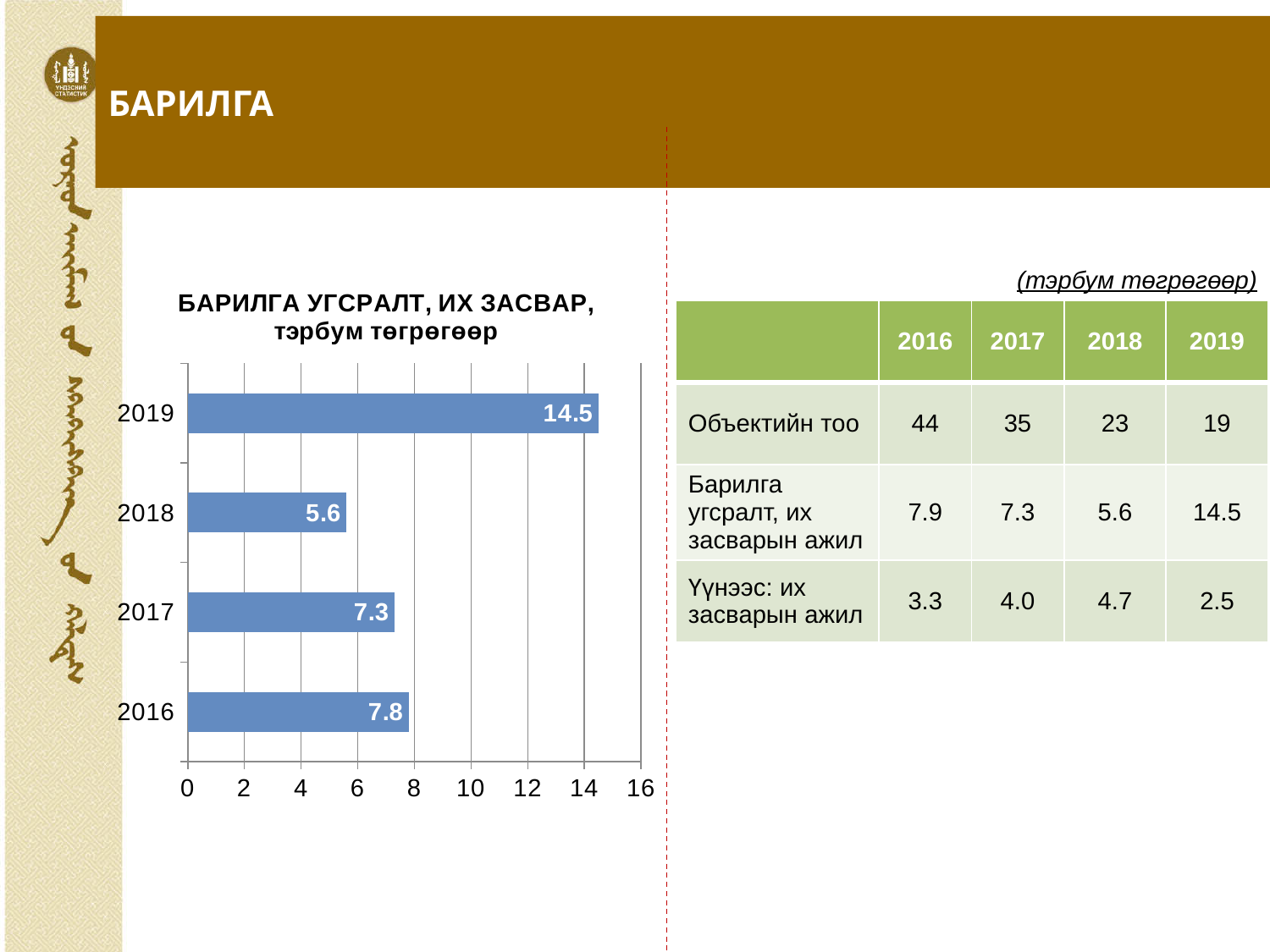
Which year has the highest value in the chart? 2019 What is the value for 2016 in the chart? 7.8 What is the difference between the values for 2016 and 2017 in the chart? 0.5 What is the value for 2018 in the chart? 5.6 Which is larger in the chart, the value for 2016 or the value for 2017? 2016 What kind of chart is shown on the slide? bar chart Which year has the lowest value in the chart? 2018 What is the difference between the values for 2019 and 2018 in the chart? 8.9 What is the value for 2019 in the chart? 14.5 How many years are shown in the chart? 4 Is the value for 2019 in the chart greater or less than 12? greater What is the value for 2017 in the chart? 7.3